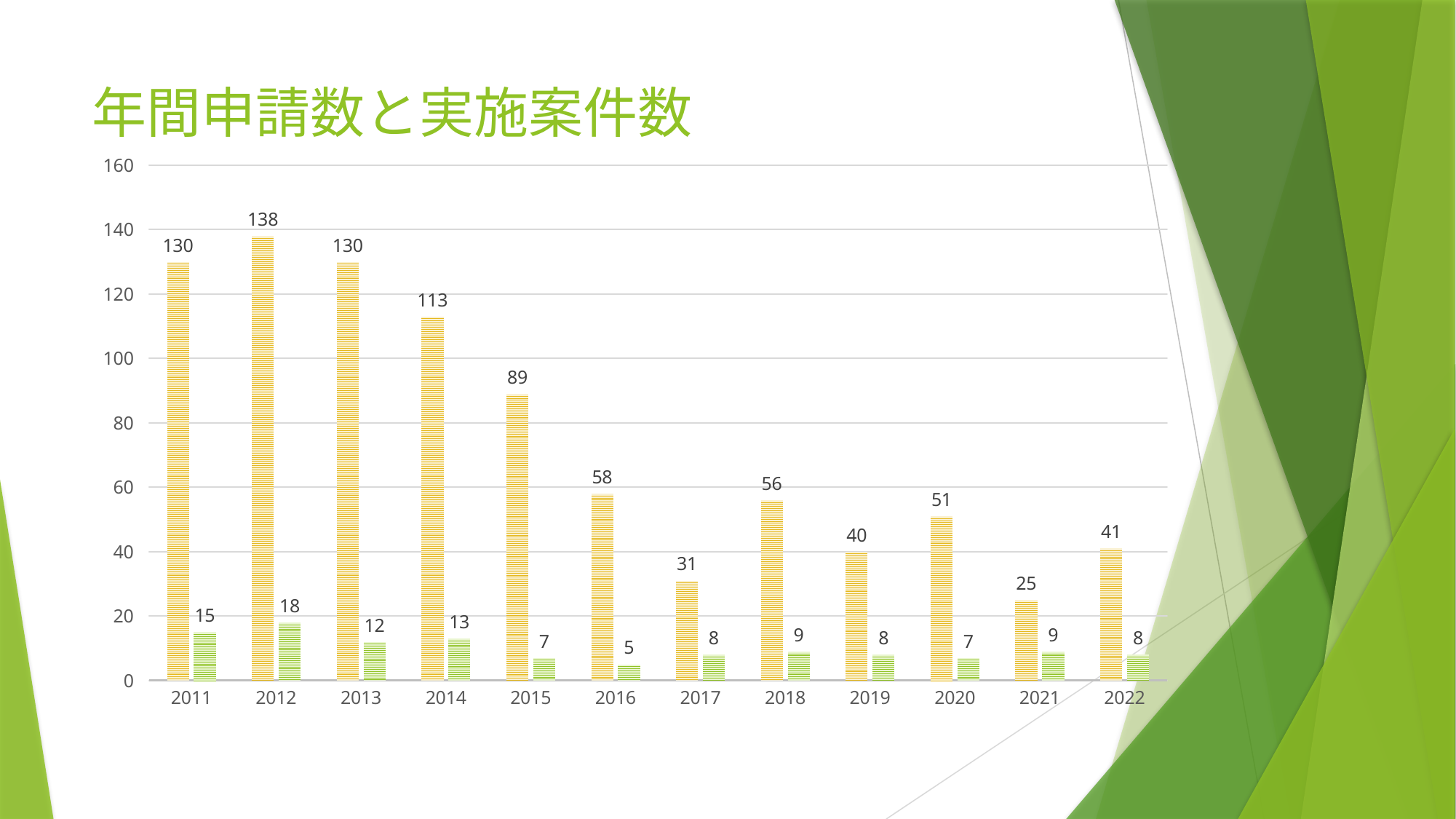
Which year has the lowest green bar? 2016 Which year has the highest orange bar? 2012 What kind of chart is shown on the slide? bar chart What is the value of the green bar for 2012? 18 What is the value of the orange bar for 2014? 113 Which is larger, the orange bar for 2018 or the orange bar for 2019? 2018 How many years are shown on the x axis? 12 What is the difference between the orange bar values for 2012 and 2013? 8 Which year has the lowest orange bar? 2021 What is the title of the chart? 年間申請数と実施案件数 What is the value of the orange bar for 2020? 51 What is the difference between the orange and green bar values for 2015? 82